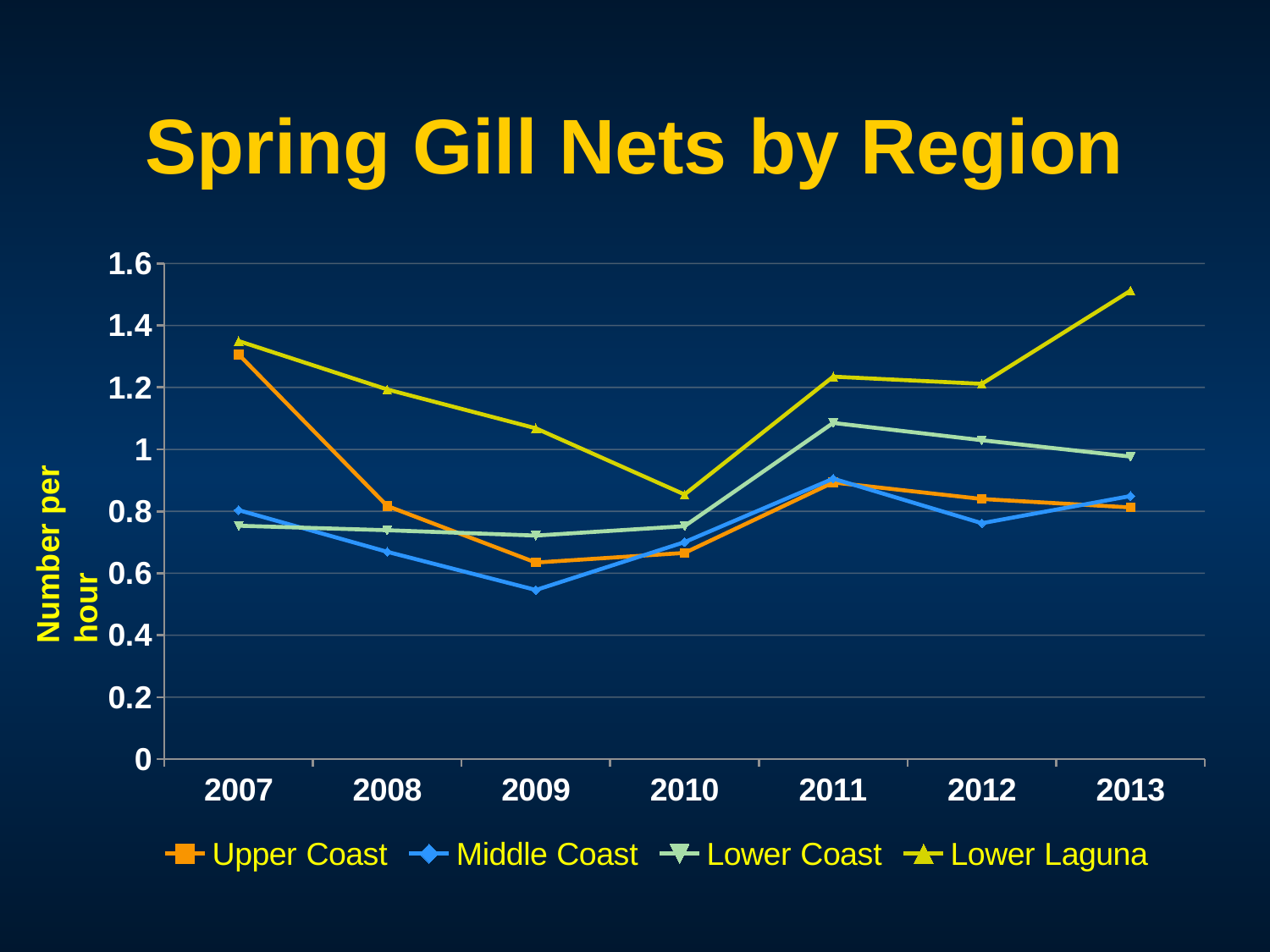
Which region has the highest value in 2013? Lower Laguna Is the value for Upper Coast in 2007 greater or less than 1.2? greater Which is larger in 2007, the value for Upper Coast or the value for Middle Coast? Upper Coast Is the value for Middle Coast in 2009 greater or less than 0.6? less How many series does the legend list? 4 Is the value for Lower Laguna in 2013 greater or less than 1.4? greater What is the label on the y axis? Number per hour In which year does Lower Laguna reach its highest value? 2013 How many years are plotted along the x axis? 7 Which region has the lowest value in 2009? Middle Coast What kind of chart is shown on the slide? line chart Does the Lower Laguna line rise or fall from 2007 to 2010? fall